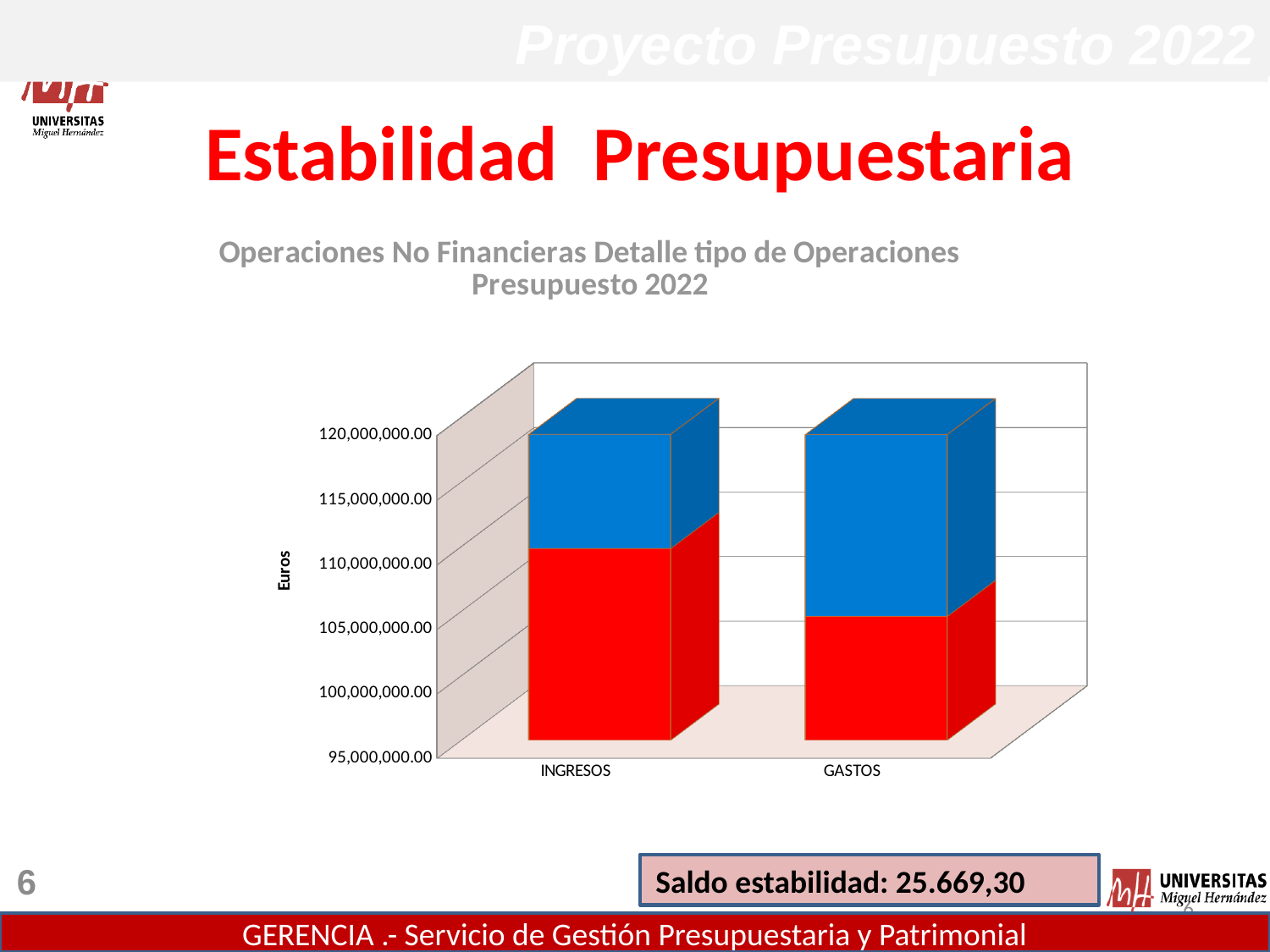
What is the lowest value shown on the vertical axis of the chart? 95,000,000.00 Which category has the larger red segment, INGRESOS or GASTOS? INGRESOS Is the top of the red segment for GASTOS greater or less than 100,000,000.00? greater What is the title of the chart? Operaciones No Financieras Detalle tipo de Operaciones Presupuesto 2022 Is the top of the red segment for INGRESOS greater or less than 105,000,000.00? greater Is the top of the red segment for INGRESOS greater or less than 115,000,000.00? less What is the label of the vertical axis of the chart? Euros Which category has the larger blue segment, INGRESOS or GASTOS? GASTOS What kind of chart is shown on the slide? Stacked bar chart How many categories are shown on the x axis of the chart? 2